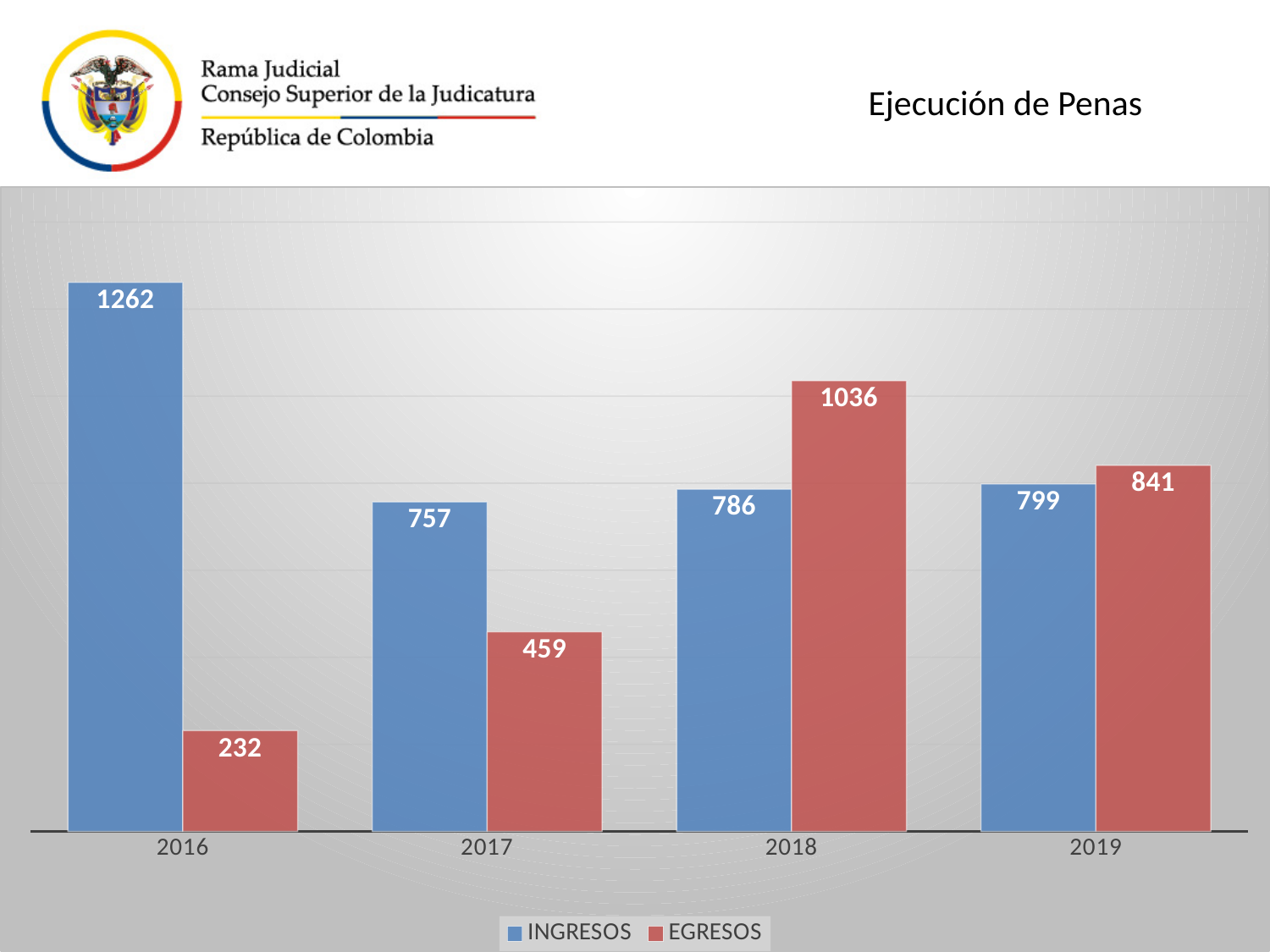
What is the difference between EGRESOS in 2018 and EGRESOS in 2017? 577 What is the EGRESOS value for 2018? 1036 What is the difference between INGRESOS and EGRESOS in 2016? 1030 Which year has the highest INGRESOS value? 2016 What is the INGRESOS value for 2016? 1262 What kind of chart is shown on the slide? Bar chart How many series does the legend list? 2 Which is larger in 2019, INGRESOS or EGRESOS? EGRESOS Does the EGRESOS series rise or fall from 2016 to 2018? Rise How many years are shown on the x axis? 4 Which year has the lowest EGRESOS value? 2016 What is the EGRESOS value for 2017? 459